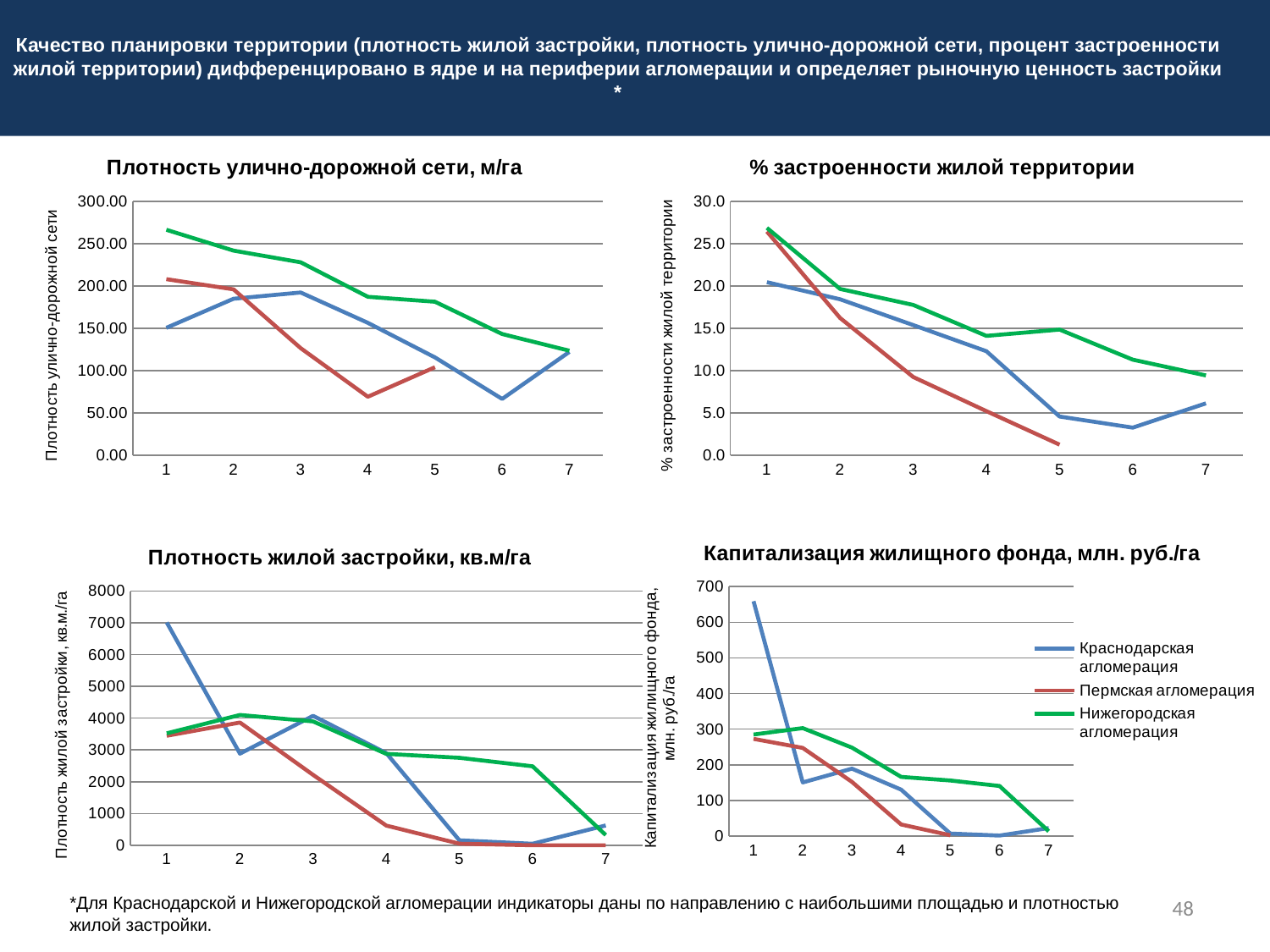
In the 'Плотность улично-дорожной сети, м/га' chart, is the value for Нижегородская агломерация at point 1 greater or less than 250? greater In the '% застроенности жилой территории' chart, is the value for Пермская агломерация at point 5 greater or less than 5.0? less In the 'Плотность улично-дорожной сети, м/га' chart, is the value for Краснодарская агломерация at point 6 greater or less than 100? less In the 'Плотность улично-дорожной сети, м/га' chart, which series has the highest value at point 1? Нижегородская агломерация How many points are on the x axis of the '% застроенности жилой территории' chart? 7 In the 'Плотность жилой застройки, кв.м/га' chart, at point 4, which is larger: Нижегородская агломерация or Пермская агломерация? Нижегородская агломерация In the 'Капитализация жилищного фонда, млн. руб./га' chart, do the values for Нижегородская агломерация generally rise or fall from point 1 to point 7? fall Which series is drawn in red in the 'Капитализация жилищного фонда, млн. руб./га' chart legend? Пермская агломерация What kind of chart is the 'Плотность улично-дорожной сети, м/га' chart? line chart How many series does the legend on the 'Капитализация жилищного фонда, млн. руб./га' chart list? 3